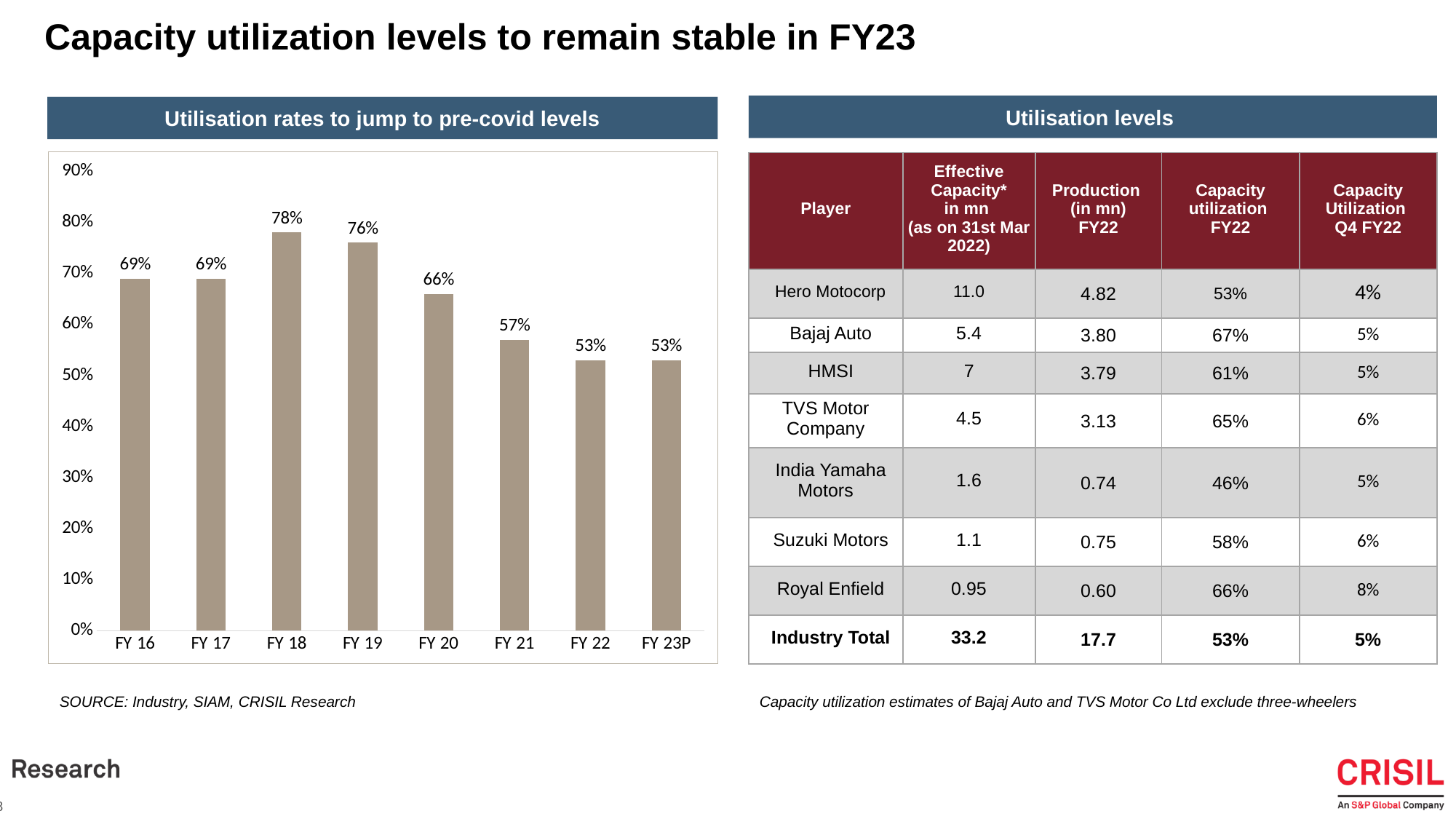
What is the utilisation rate for FY 20? 66% What is the difference in utilisation rate between FY 18 and FY 22? 25 percentage points Which is larger, the utilisation rate for FY 19 or FY 21? FY 19 What is the title of the chart? Utilisation rates to jump to pre-covid levels What is the difference in utilisation rate between FY 20 and FY 21? 9 percentage points What is the utilisation rate for FY 18? 78% Which fiscal year has the highest utilisation rate? FY 18 Is the utilisation rate for FY 21 greater or less than 60%? less What is the utilisation rate for FY 23P? 53% How many fiscal years are shown on the chart? 8 Do utilisation rates rise or fall from FY 19 to FY 22? fall What kind of chart is shown on the slide? bar chart